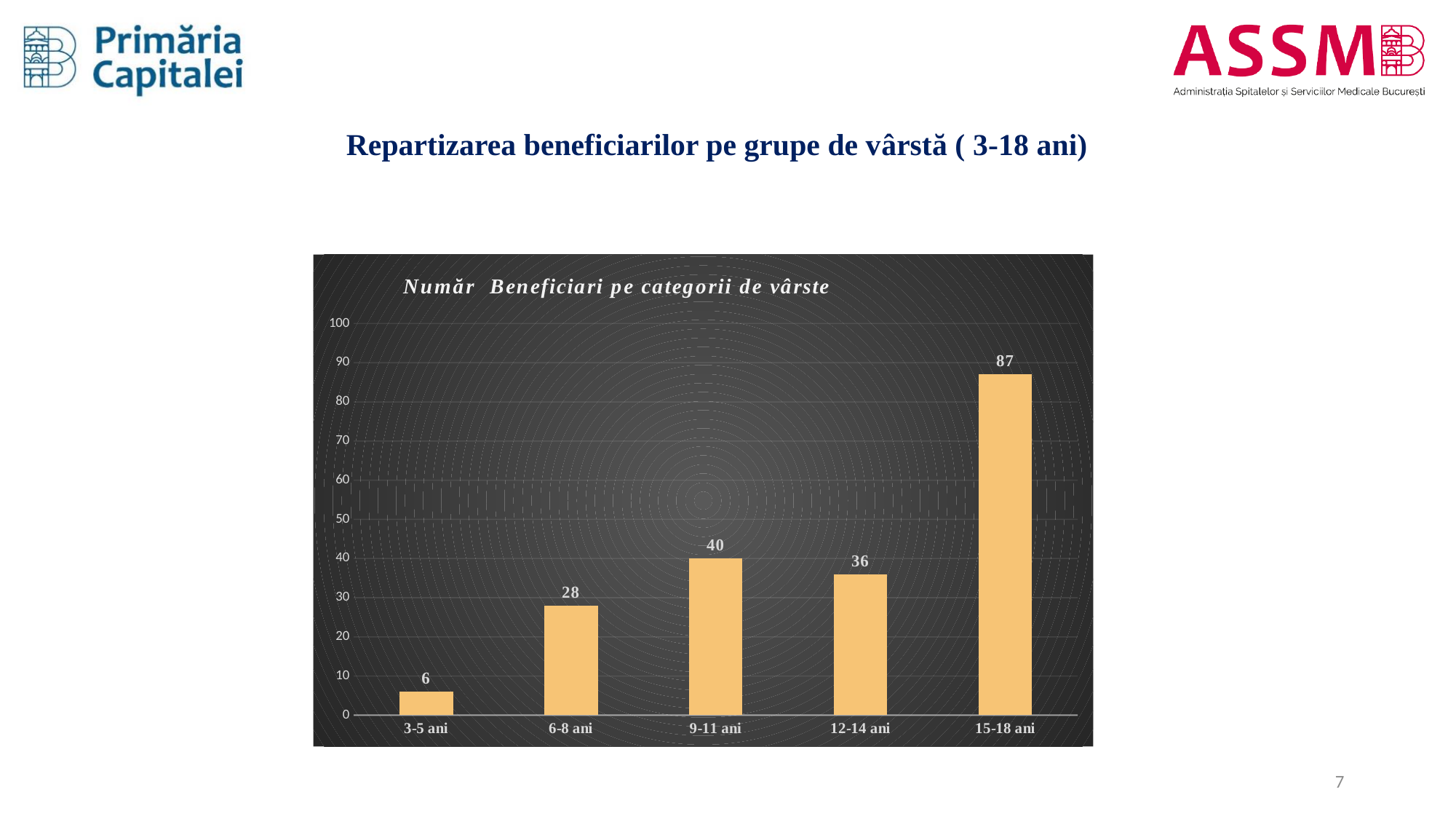
How many age groups are shown on the chart? 5 What is the number of beneficiaries for the 12-14 ani age group? 36 What is the number of beneficiaries for the 15-18 ani age group? 87 What is the number of beneficiaries for the 3-5 ani age group? 6 What is the difference in beneficiaries between the 15-18 ani and 9-11 ani age groups? 47 Which age group has the lowest number of beneficiaries? 3-5 ani Which age group has more beneficiaries, 9-11 ani or 12-14 ani? 9-11 ani What type of chart is shown on the slide? Bar chart What is the title of the chart? Număr Beneficiari pe categorii de vârste Which age group has the highest number of beneficiaries? 15-18 ani What is the number of beneficiaries for the 9-11 ani age group? 40 What is the number of beneficiaries for the 6-8 ani age group? 28